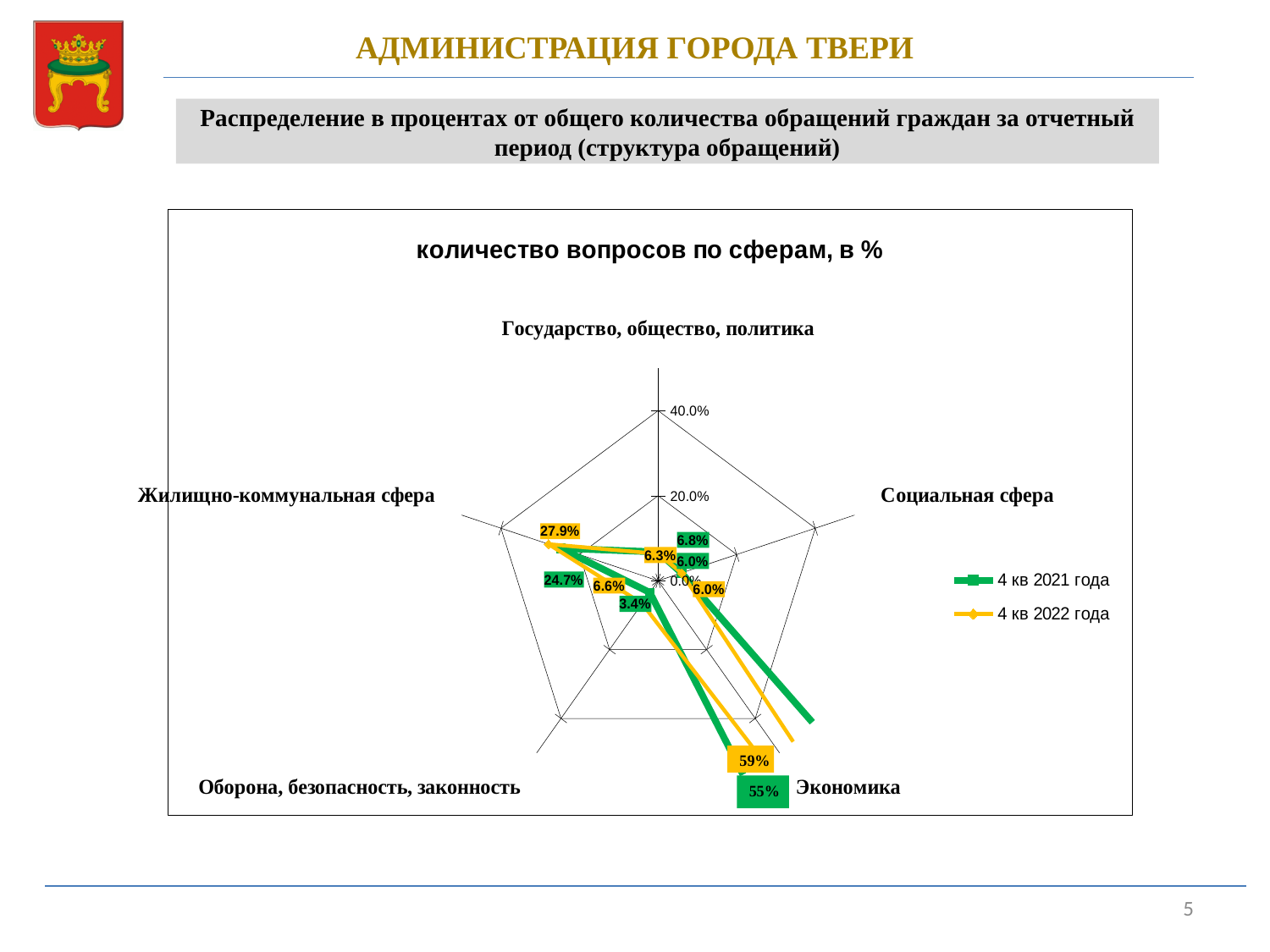
What is the value for Оборона, безопасность, законность in the series 4 кв 2021 года? 3.4% How many series does the legend list? 2 Which category has the lowest value in the series 4 кв 2021 года? Оборона, безопасность, законность For Экономика, which series has the larger value: 4 кв 2021 года or 4 кв 2022 года? 4 кв 2021 года What is the title of the chart? количество вопросов по сферам, в % Which category has the highest value in the series 4 кв 2022 года? Экономика What kind of chart is shown on the slide? radar chart How many categories (axes) does the radar chart have? 5 What is the value for Жилищно-коммунальная сфера in the series 4 кв 2022 года? 27.9% What is the value for Жилищно-коммунальная сфера in the series 4 кв 2021 года? 24.7%